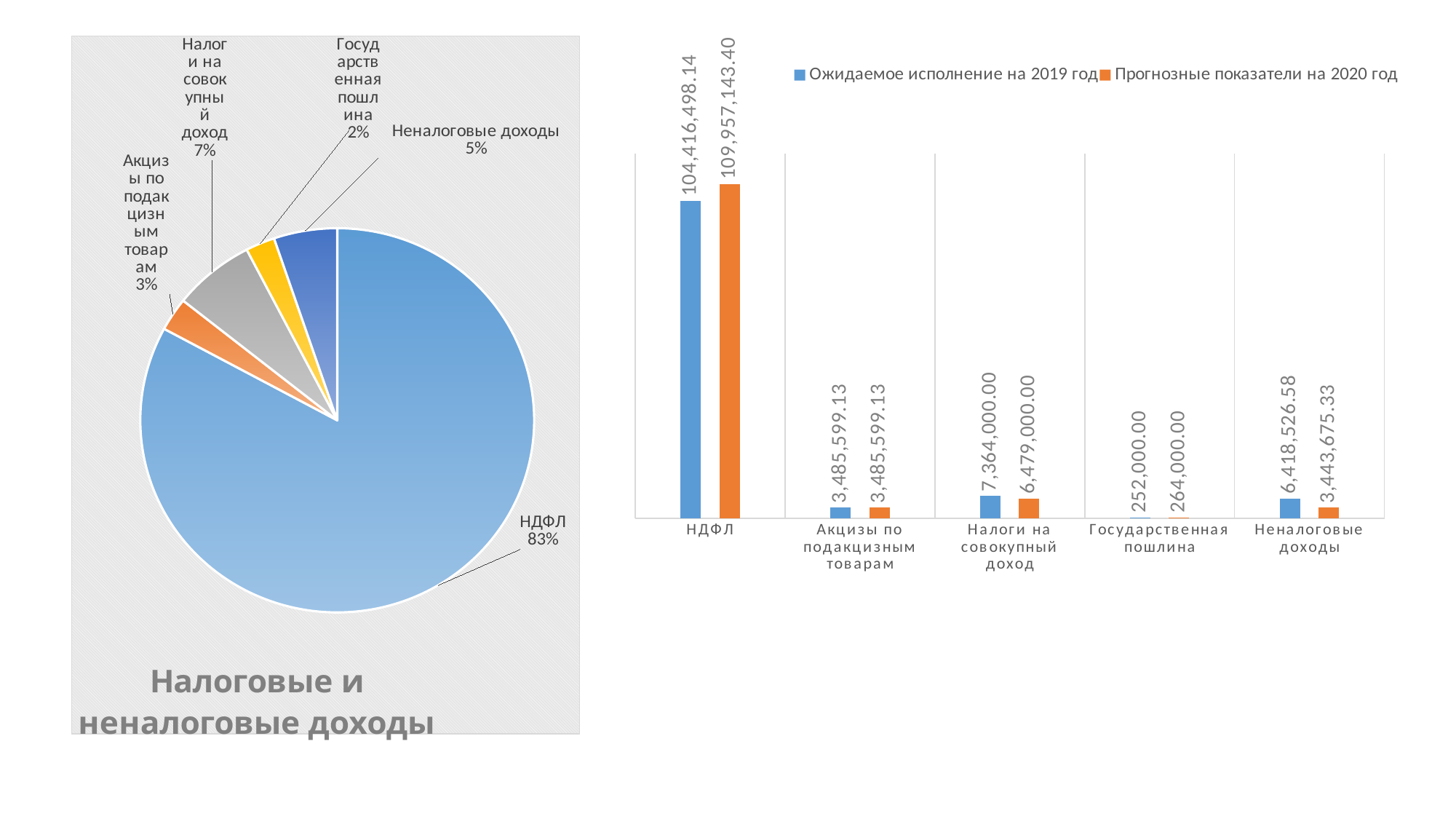
In the bar chart on the right, what is the difference between the 2020 forecast and the 2019 expected value for 'Государственная пошлина'? 12,000.00 What kind of chart is the chart on the left of the slide? Pie chart In the bar chart on the right, which category has the highest value for 'Прогнозные показатели на 2020 год'? НДФЛ How many slices does the pie chart 'Налоговые и неналоговые доходы' have? 5 In the bar chart on the right, what is the value of 'Ожидаемое исполнение на 2019 год' for НДФЛ? 104,416,498.14 In the bar chart on the right, what is the value of 'Прогнозные показатели на 2020 год' for 'Неналоговые доходы'? 3,443,675.33 In the pie chart 'Налоговые и неналоговые доходы', what share does НДФЛ have? 83% In the bar chart on the right, which is larger for 'Налоги на совокупный доход': the 2019 expected value or the 2020 forecast? Ожидаемое исполнение на 2019 год In the pie chart 'Налоговые и неналоговые доходы', which category has the smallest slice? Государственная пошлина In the bar chart on the right, how many series does the legend list? 2 What kind of chart is the chart on the right of the slide? Bar chart In the pie chart 'Налоговые и неналоговые доходы', what share does 'Налоги на совокупный доход' have? 7%